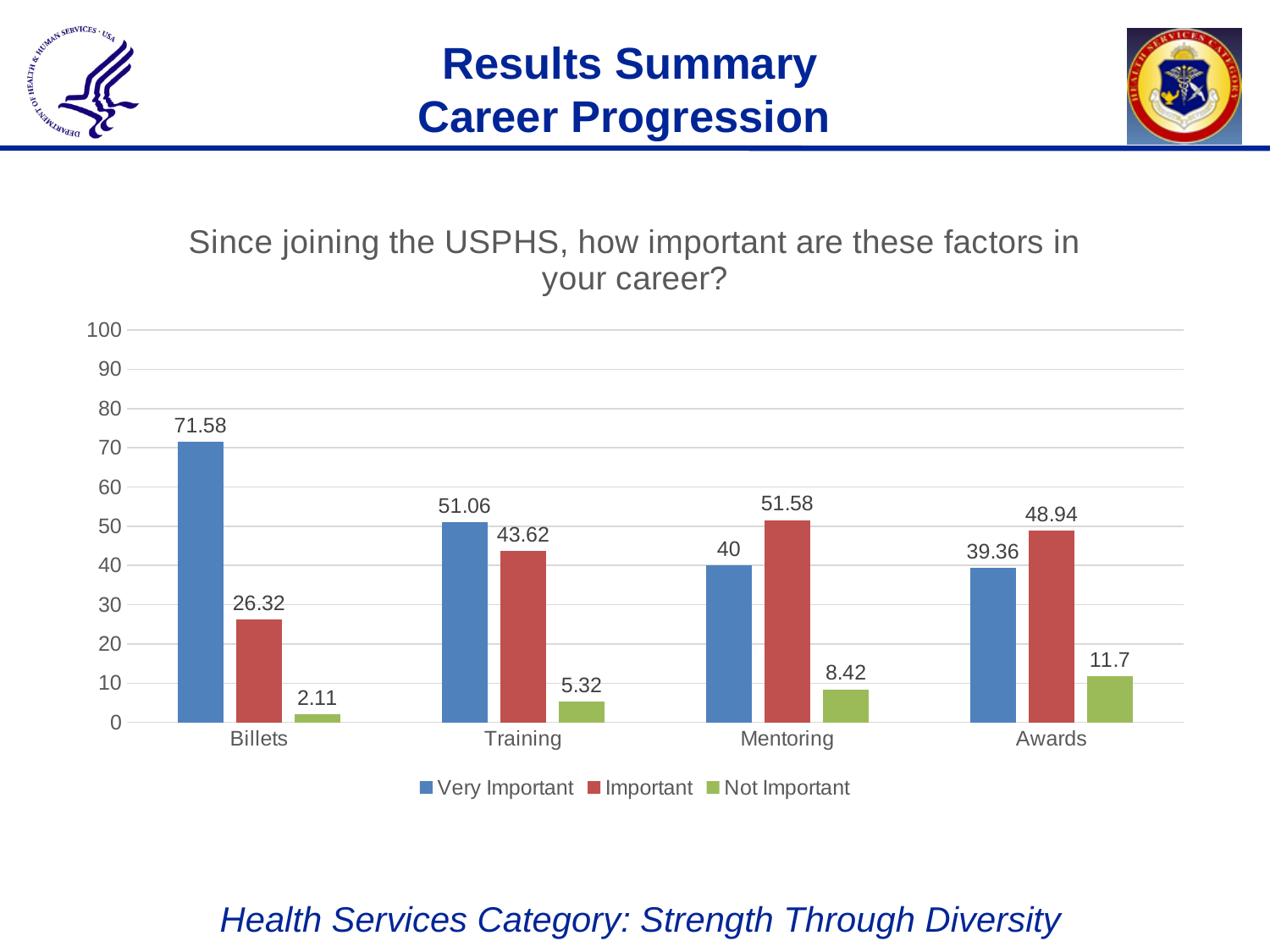
What is the value for Not Important for Mentoring? 8.42 How many categories are shown on the x axis? 4 What is the value for Important for Awards? 48.94 Which category has the highest Very Important value? Billets Which category has the lowest Not Important value? Billets What is the difference between the Very Important values for Billets and Training? 20.52 Which is larger for Mentoring: Very Important or Important? Important How many series does the legend list? 3 What is the value for Very Important for Billets? 71.58 What kind of chart is shown on the slide? bar chart What colour represents the Not Important series? green Is the Important value for Training greater or less than 40? greater